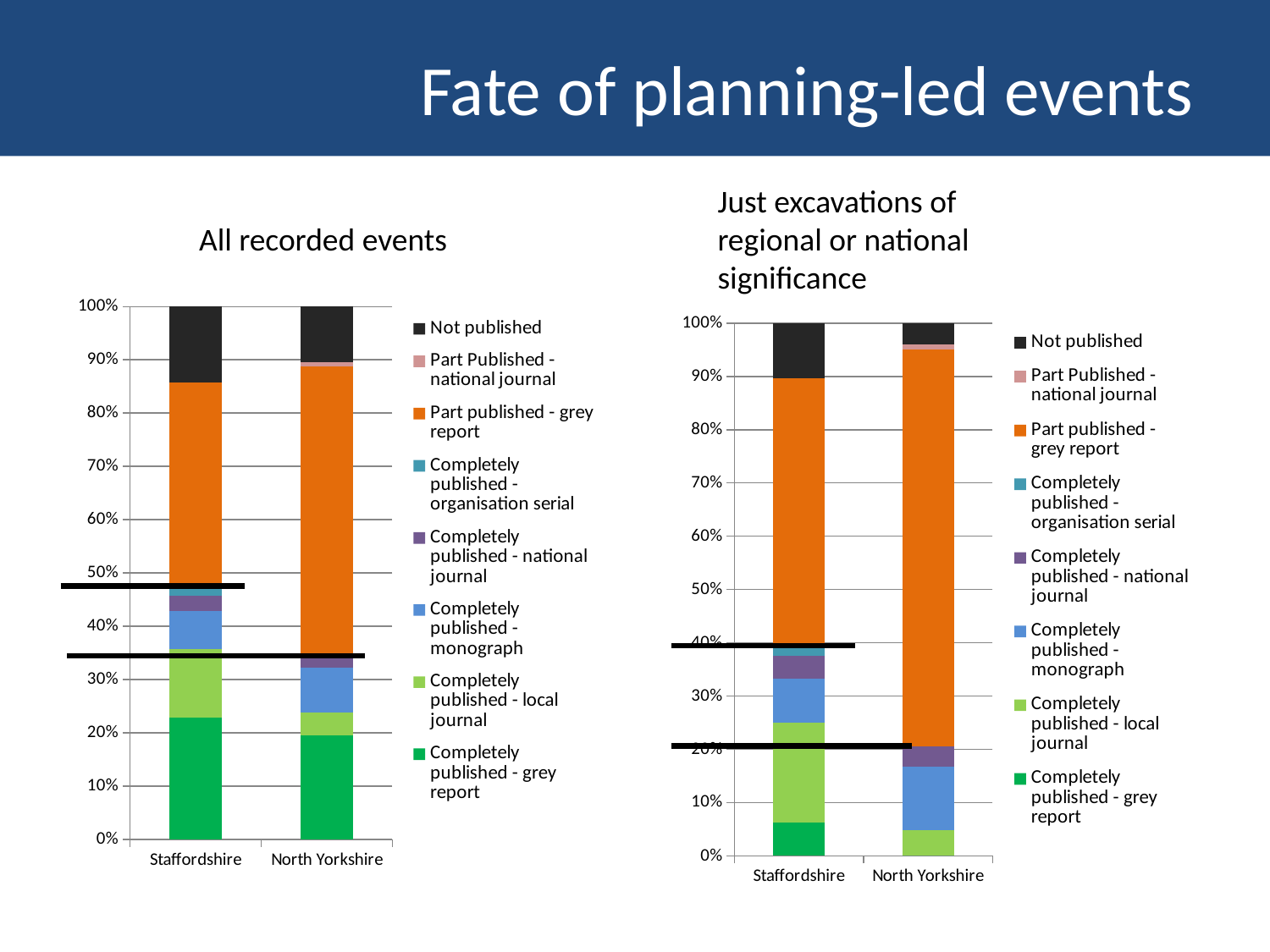
In the 'Just excavations of regional or national significance' chart, which category has the larger 'Part published - grey report' segment, Staffordshire or North Yorkshire? North Yorkshire How many series does the legend of the 'Just excavations of regional or national significance' chart list? 8 What is the title of the chart on the left of the slide? All recorded events In the 'All recorded events' chart, is the 'Completely published - grey report' value for Staffordshire greater or less than 20%? greater How many categories are shown on the x axis of the 'All recorded events' chart? 2 In the 'Just excavations of regional or national significance' chart, is the 'Completely published - grey report' value for Staffordshire greater or less than 10%? less In the 'Just excavations of regional or national significance' chart, which category has the larger 'Not published' segment, Staffordshire or North Yorkshire? Staffordshire In the 'Just excavations of regional or national significance' chart, is the 'Completely published - local journal' value for North Yorkshire greater or less than 10%? less In the 'All recorded events' chart, what is the total height of the Staffordshire stacked bar? 100% In the 'All recorded events' chart, which series is listed first in the legend? Not published What kind of chart is the 'All recorded events' chart? Stacked bar chart In the 'All recorded events' chart, which category has the larger 'Completely published - local journal' segment, Staffordshire or North Yorkshire? Staffordshire